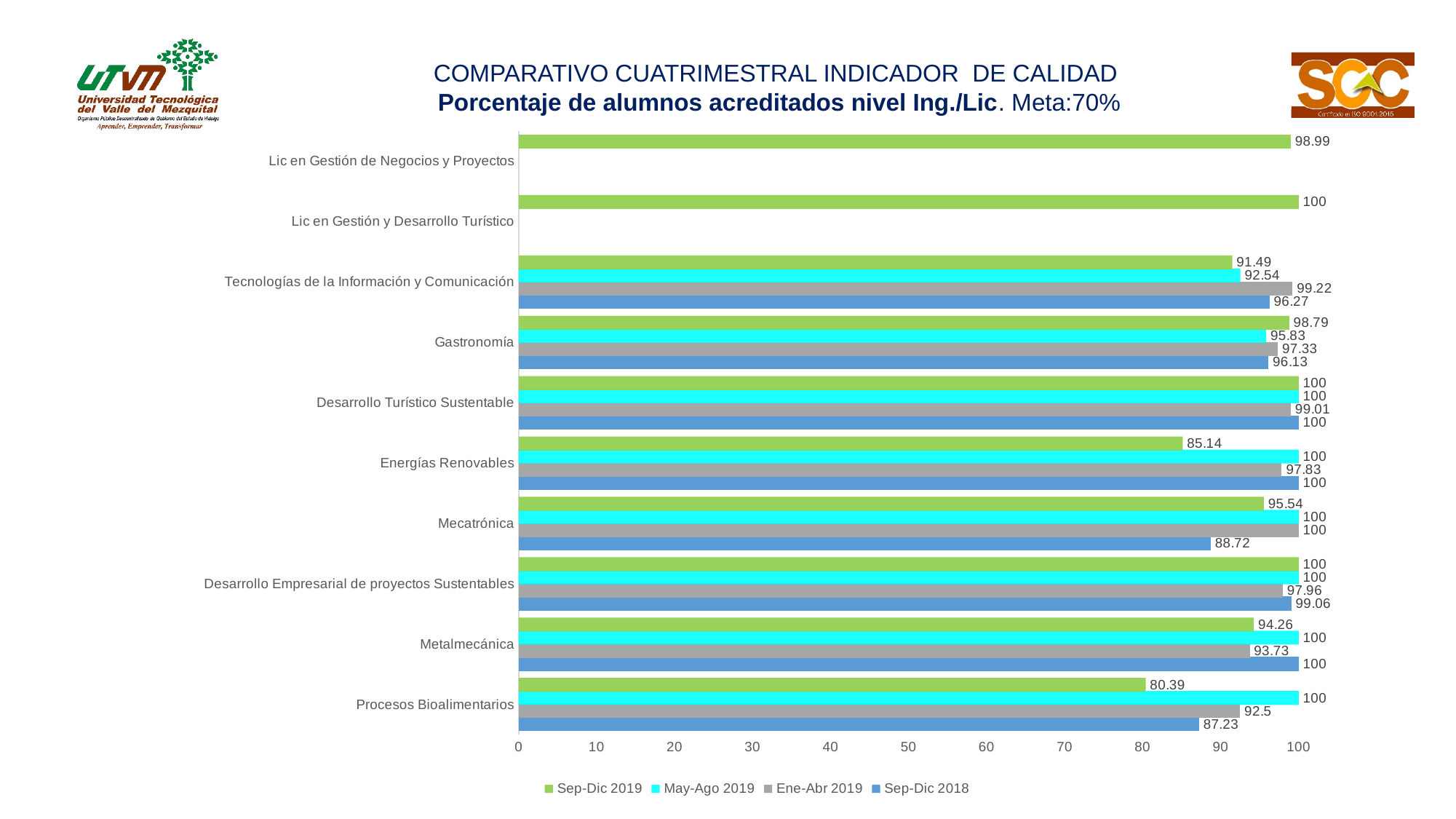
What is the Sep-Dic 2018 value for Mecatrónica? 88.72 How many categories (programs) are shown on the chart? 10 Which category has the lowest Sep-Dic 2019 value? Procesos Bioalimentarios What is the Ene-Abr 2019 value for Tecnologías de la Información y Comunicación? 99.22 How many series does the legend list? 4 Which colour represents the Ene-Abr 2019 series in the legend? Gray What is the difference between the May-Ago 2019 and Sep-Dic 2019 values for Energías Renovables? 14.86 What is the Sep-Dic 2019 value for Lic en Gestión de Negocios y Proyectos? 98.99 What is the Sep-Dic 2019 value for Procesos Bioalimentarios? 80.39 What kind of chart is shown on the slide? Bar chart Which is larger for Gastronomía: the Sep-Dic 2019 value or the May-Ago 2019 value? Sep-Dic 2019 Which category has the lowest Sep-Dic 2018 value? Procesos Bioalimentarios